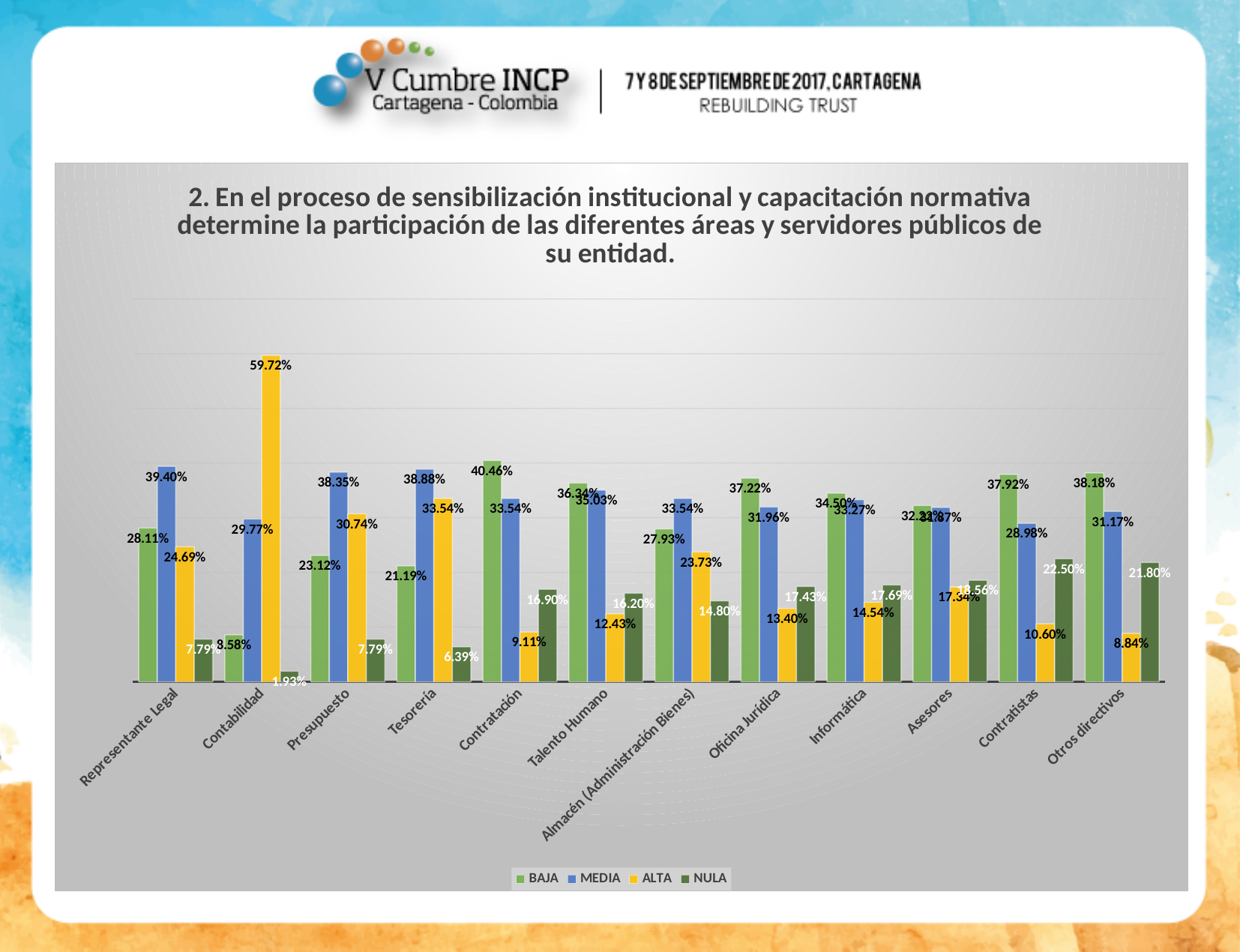
Which category has the lowest NULA value? Contabilidad What is the MEDIA value for Representante Legal? 39.40% What type of chart is shown on the slide? Bar chart How many categories (areas) are shown on the x axis? 12 What is the ALTA value for Contabilidad? 59.72% Which category has the highest ALTA value? Contabilidad What is the difference between the MEDIA and BAJA values for Presupuesto? 15.23% How many series does the legend list? 4 What is the BAJA value for Contratación? 40.46% What is the NULA value for Contratistas? 22.50% Which series is shown in yellow in the legend? ALTA Which is larger for Otros directivos, the BAJA value or the MEDIA value? BAJA